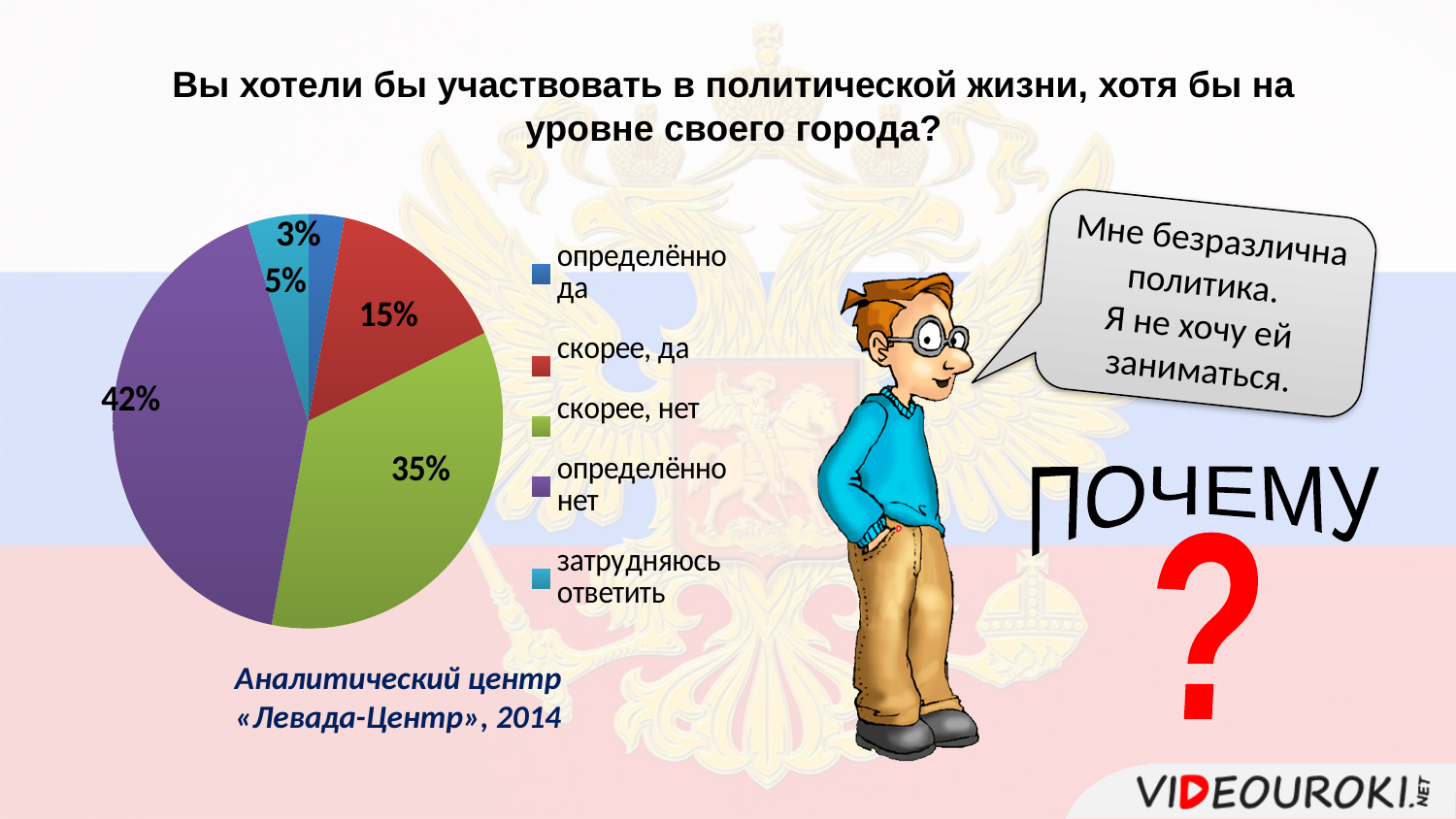
What percentage of respondents answered «затрудняюсь ответить»? 5% Which is larger: the share for «скорее, да» or the share for «затрудняюсь ответить»? скорее, да What percentage of respondents answered «скорее, да»? 15% How many answer options (slices) does the pie chart have? 5 What is the difference in percentage points between «определённо нет» and «скорее, нет»? 7 What percentage of respondents answered «определённо да»? 3% Which answer option has the largest share of the pie? определённо нет Which source is cited below the chart? Аналитический центр «Левада-Центр», 2014 What percentage of respondents answered «определённо нет»? 42% Which answer option has the smallest share of the pie? определённо да What kind of chart is shown on the slide? pie chart What percentage of respondents answered «скорее, нет»? 35%